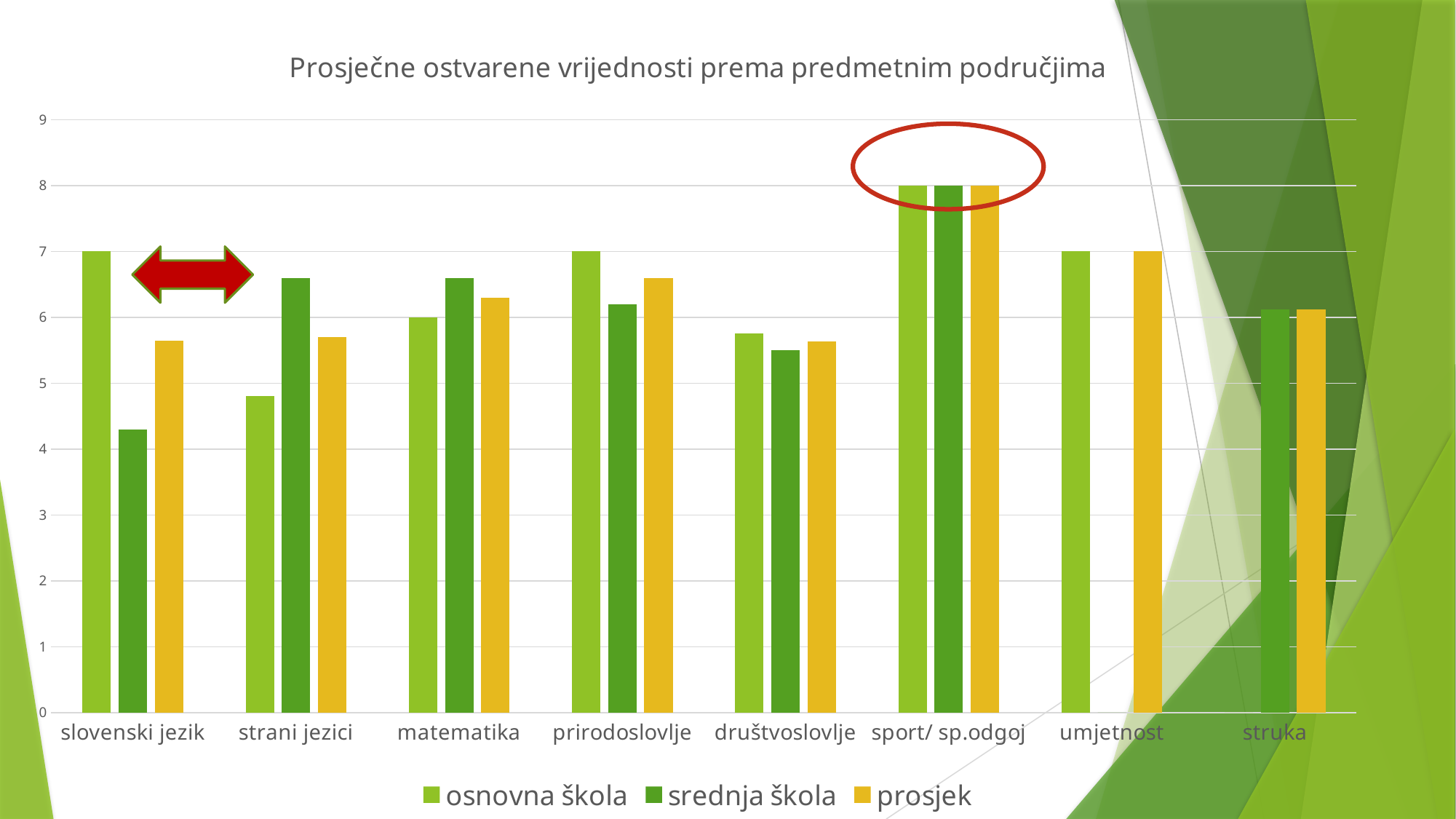
In strani jezici, which is larger: osnovna škola or srednja škola? srednja škola What is the value for osnovna škola in slovenski jezik? 7 How many subject categories are shown on the x axis? 8 How many series does the legend list? 3 What kind of chart is shown on the slide? bar chart What is the title of the chart? Prosječne ostvarene vrijednosti prema predmetnim područjima What is the value for srednja škola in sport/ sp.odgoj? 8 What is the value for prosjek in umjetnost? 7 Which category has the highest prosjek value? sport/ sp.odgoj Is the value for srednja škola in slovenski jezik greater or less than 5? less Is the value for srednja škola in strani jezici greater or less than 6? greater